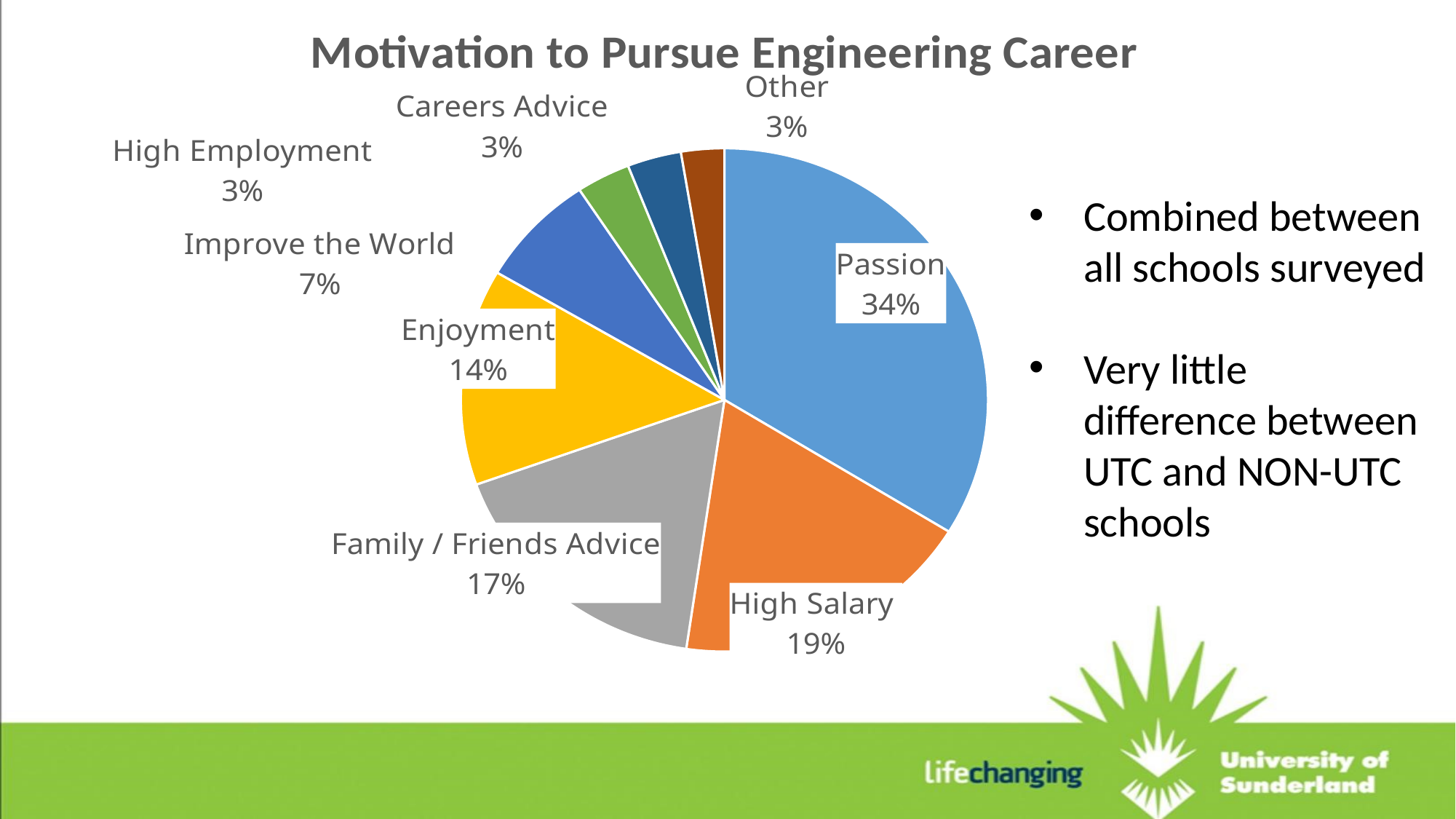
What colour is the Passion slice? Blue How many categories are shown in the pie chart? 8 What is the difference between the Passion and High Salary values? 15% What is the title of the chart? Motivation to Pursue Engineering Career What is the value for Enjoyment? 14% What is the value for Improve the World? 7% Which category has the largest slice of the pie? Passion Which is larger, Enjoyment or Family / Friends Advice? Family / Friends Advice What is the value for Family / Friends Advice? 17% What share of the pie does Passion account for? 34% What type of chart is shown on the slide? Pie chart What is the value for High Salary? 19%